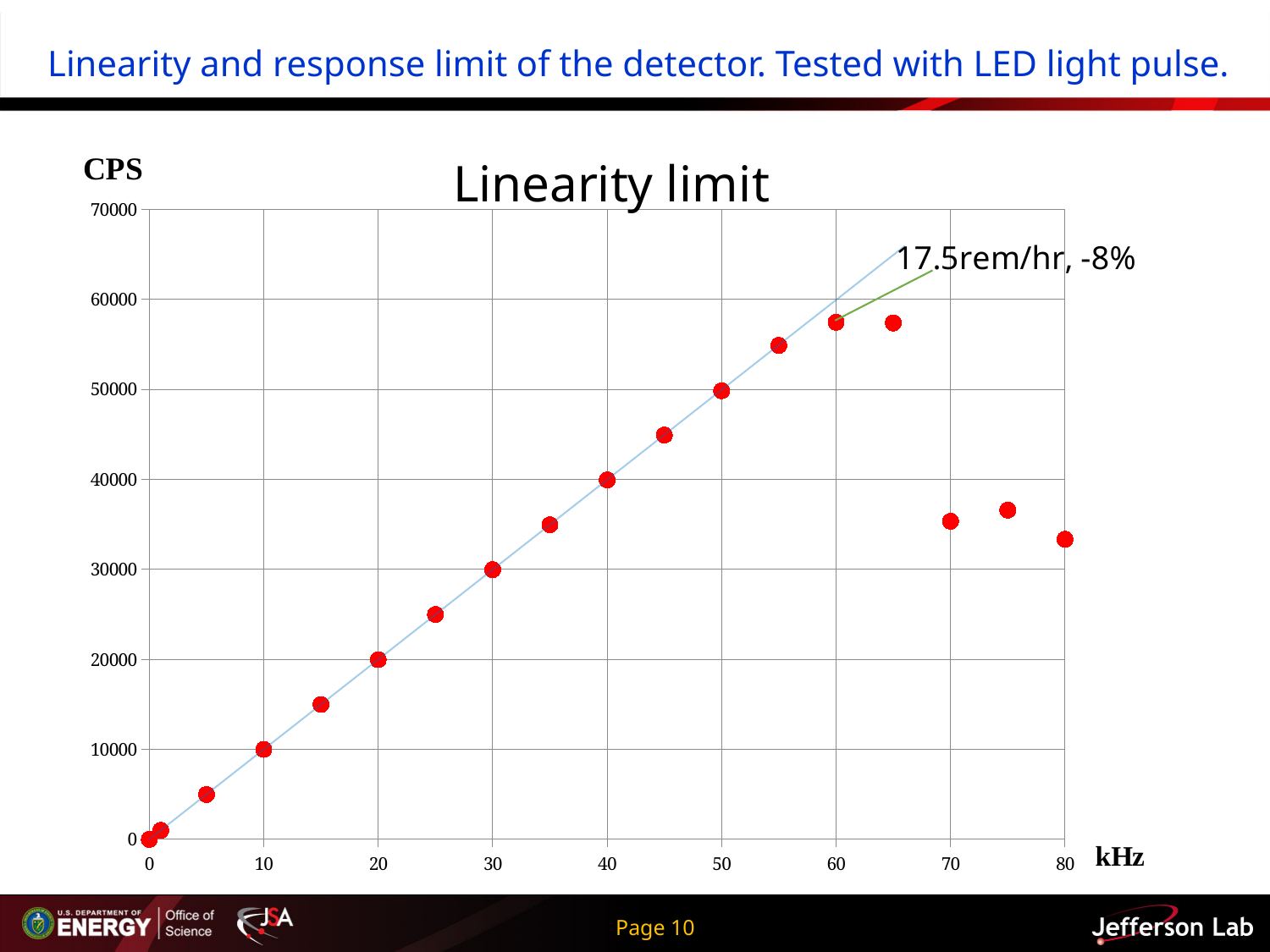
Do the CPS values rise or fall as kHz increases from 0 to 60? rise Is the CPS value at 65 kHz greater or less than 50000? greater What kind of chart is shown on the slide? scatter chart Is the CPS value at 80 kHz greater or less than 40000? less Is the CPS value at 70 kHz greater or less than 40000? less At which kHz value is the lowest CPS point plotted? 0 Which has the higher CPS value, the point at 60 kHz or the point at 70 kHz? 60 kHz What is the label on the vertical axis of the chart? CPS What is the title of the chart? Linearity limit